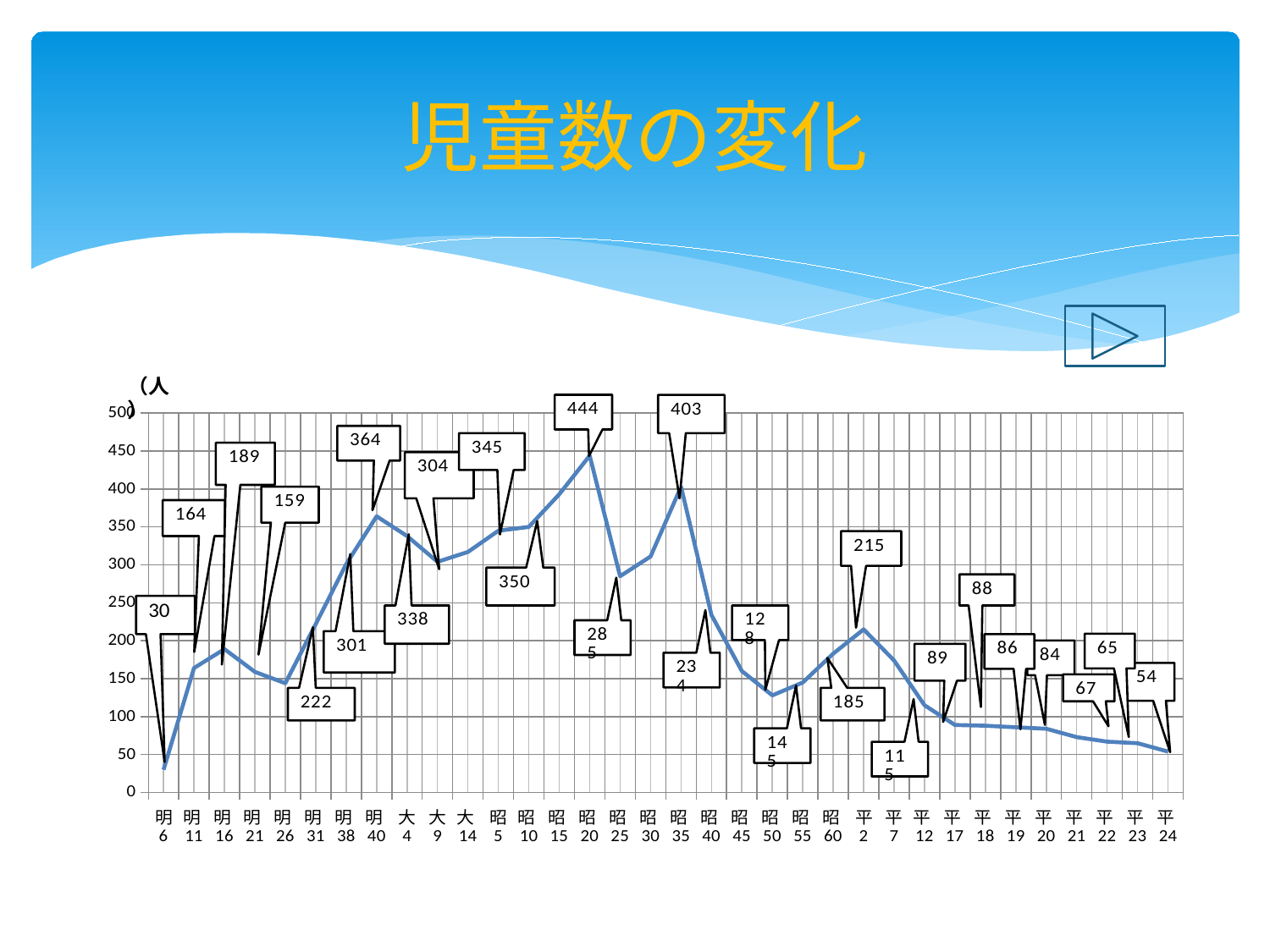
What is the difference between the values for 昭20 and 昭35? 41 What is the title of the chart? 児童数の変化 Which category has the lowest value? 明6 Which is larger, the value for 明40 or the value for 昭50? 明40 How many categories are plotted along the x axis? 34 What is the value for 昭20? 444 What kind of chart is shown on the slide? line chart What is the value for 平2? 215 Is the value for 平24 greater or less than 100? less What is the value for 昭35? 403 Which category has the highest value? 昭20 What is the value for 明6? 30